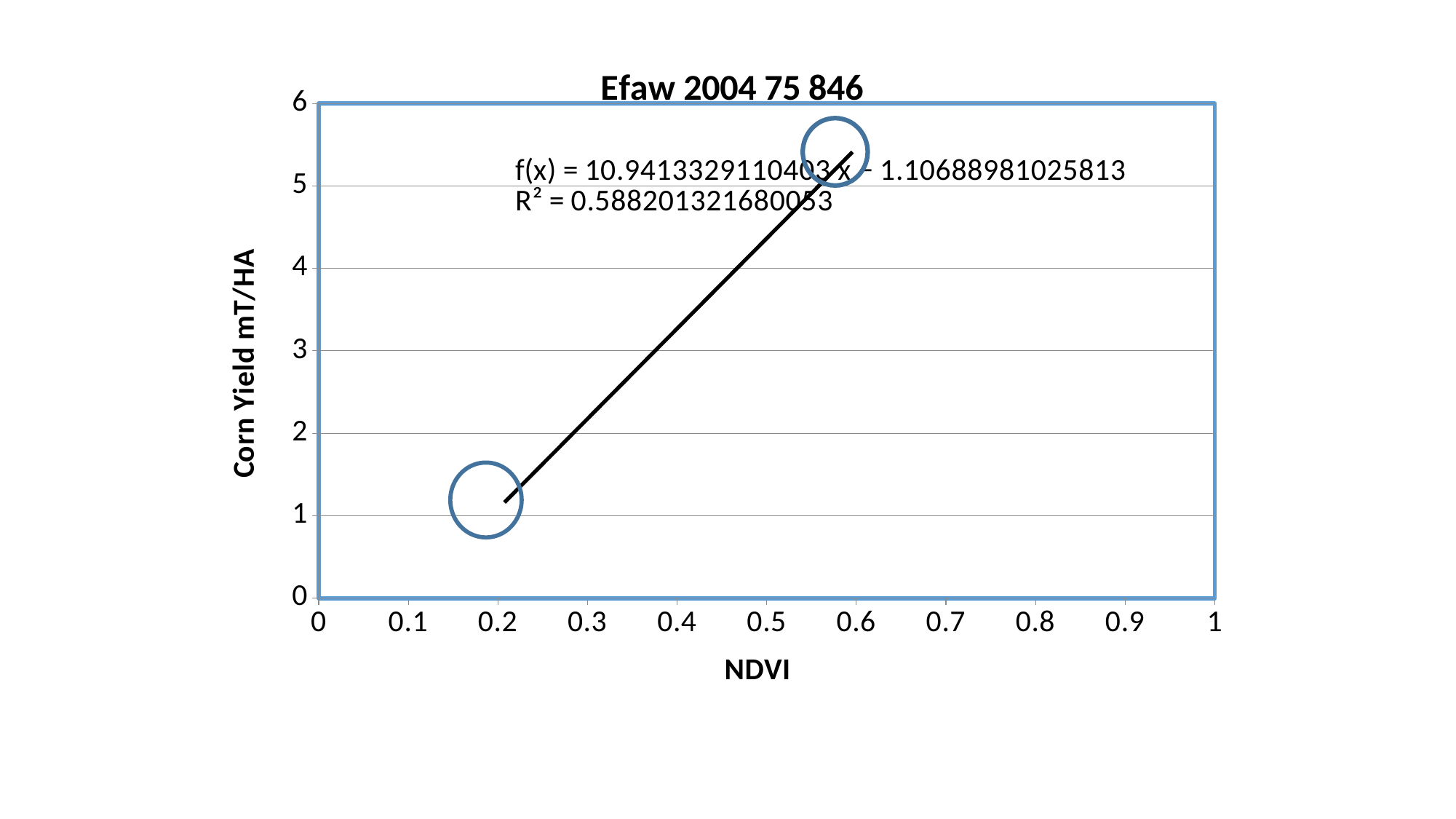
What is the label of the y axis? Corn Yield mT/HA Does corn yield rise or fall as NDVI increases along the trendline? rise What is the title of the chart? Efaw 2004 75 846 What is the highest value shown on the x axis? 1 What is the highest value shown on the y axis? 6 What R² value is printed on the chart? 0.588201321680053 Is the trendline value at the upper circled point (near NDVI 0.6) greater or less than 4? greater What is the slope of the fitted line f(x) shown on the chart? 10.9413329110403 What is the intercept of the fitted line f(x) shown on the chart? -1.10688981025813 Is the trendline value at the lower circled point (near NDVI 0.2) greater or less than 2? less What kind of chart is shown on the slide? scatter chart How many circled points are highlighted on the chart? 2